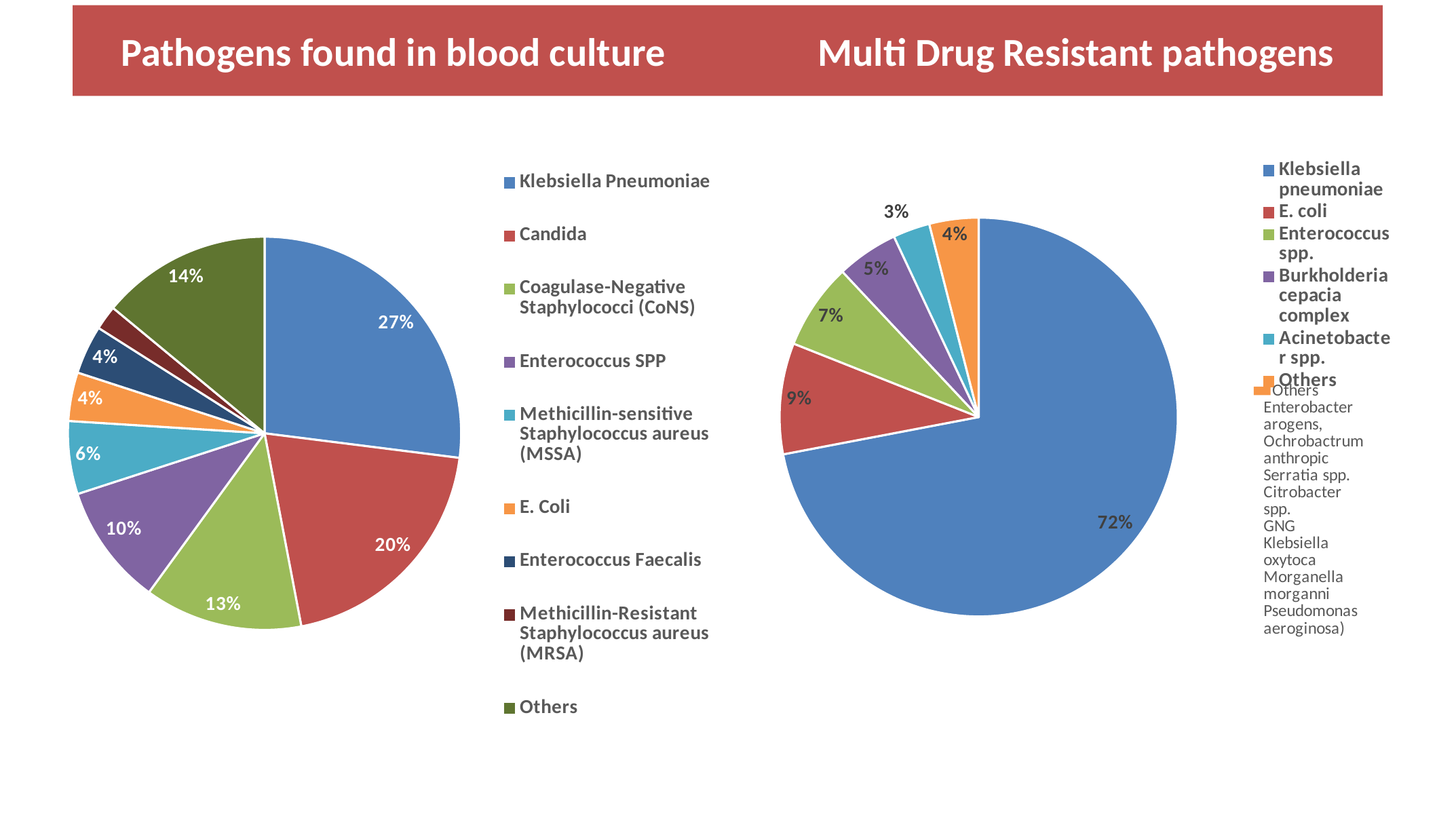
In the 'Pathogens found in blood culture' chart, which pathogen has the largest share? Klebsiella Pneumoniae What type of chart is the 'Multi Drug Resistant pathogens' chart? Pie chart In the 'Multi Drug Resistant pathogens' chart, which pathogen has the smallest share? Acinetobacter spp. How many slices does the 'Multi Drug Resistant pathogens' pie chart have? 6 In the 'Pathogens found in blood culture' chart, which is larger: Enterococcus SPP or Methicillin-sensitive Staphylococcus aureus (MSSA)? Enterococcus SPP In the 'Multi Drug Resistant pathogens' chart, what colour is the Klebsiella pneumoniae slice? Blue In the 'Multi Drug Resistant pathogens' chart, what percentage is Klebsiella pneumoniae? 72% In the 'Pathogens found in blood culture' chart, what is the difference between the Candida share and the Coagulase-Negative Staphylococci (CoNS) share? 7% In the 'Pathogens found in blood culture' chart, what percentage is Candida? 20% In the 'Multi Drug Resistant pathogens' chart, what is the difference between the E. coli share and the Enterococcus spp. share? 2% In the 'Pathogens found in blood culture' chart, what percentage is Klebsiella Pneumoniae? 27% How many entries does the legend of the 'Pathogens found in blood culture' chart list? 9